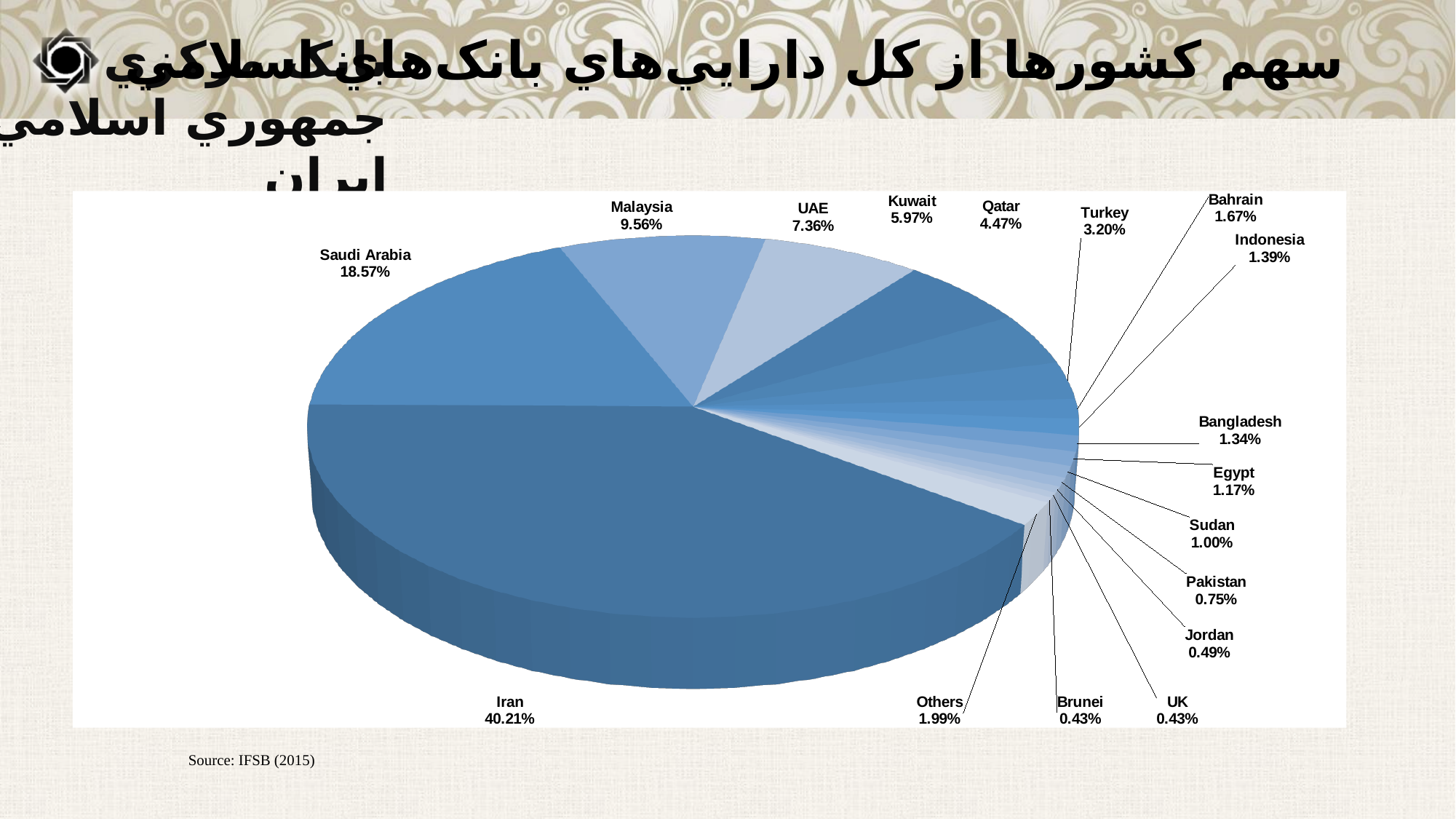
What is the difference between the shares of Iran and Saudi Arabia? 21.64% How many slices does the pie chart have? 17 What is the difference between the shares of UAE and Qatar? 2.89% What is the value shown for Saudi Arabia? 18.57% What is the value shown for Bangladesh? 1.34% Which has a larger share, Turkey or Bahrain? Turkey Which has a larger share, Egypt or Sudan? Egypt What is the value shown for Malaysia? 9.56% What share of the pie does Iran hold? 40.21% What type of chart is shown on the slide? Pie chart What is the value shown for Kuwait? 5.97% Which country has the largest slice of the pie? Iran